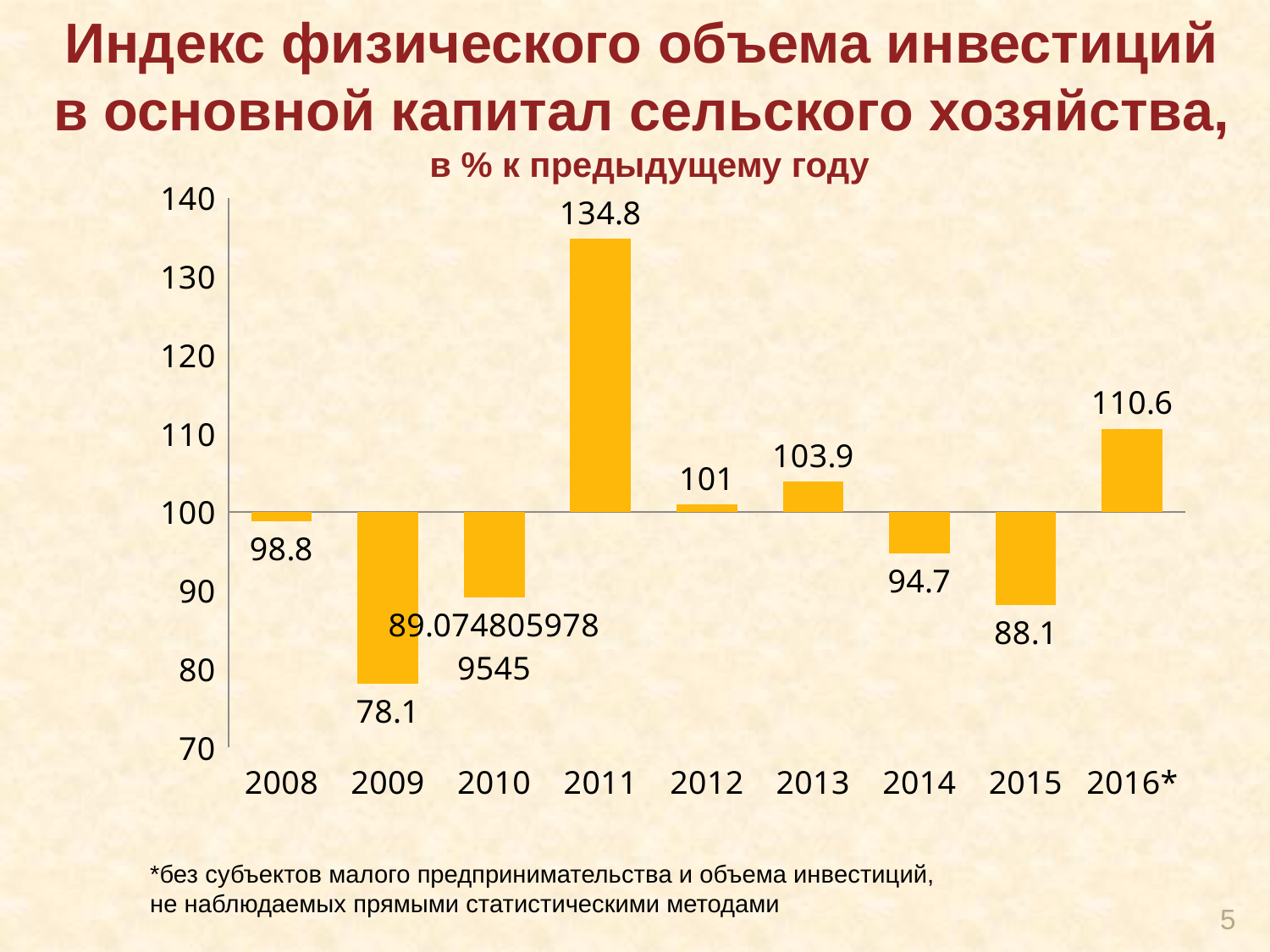
What is the value for 2011? 134.8 What is the difference between the values for 2011 and 2009? 56.7 Is the value for 2010 greater or less than 100? less Which year has the lowest value? 2009 What type of chart is shown on the slide? Bar chart What is the difference between the values for 2016* and 2015? 22.5 Which is larger, the value for 2014 or the value for 2015? 2014 How many years are shown on the x axis? 9 What is the value for 2009? 78.1 What unit does the chart subtitle say the values are expressed in? в % к предыдущему году What is the value for 2016*? 110.6 Which year has the highest value? 2011